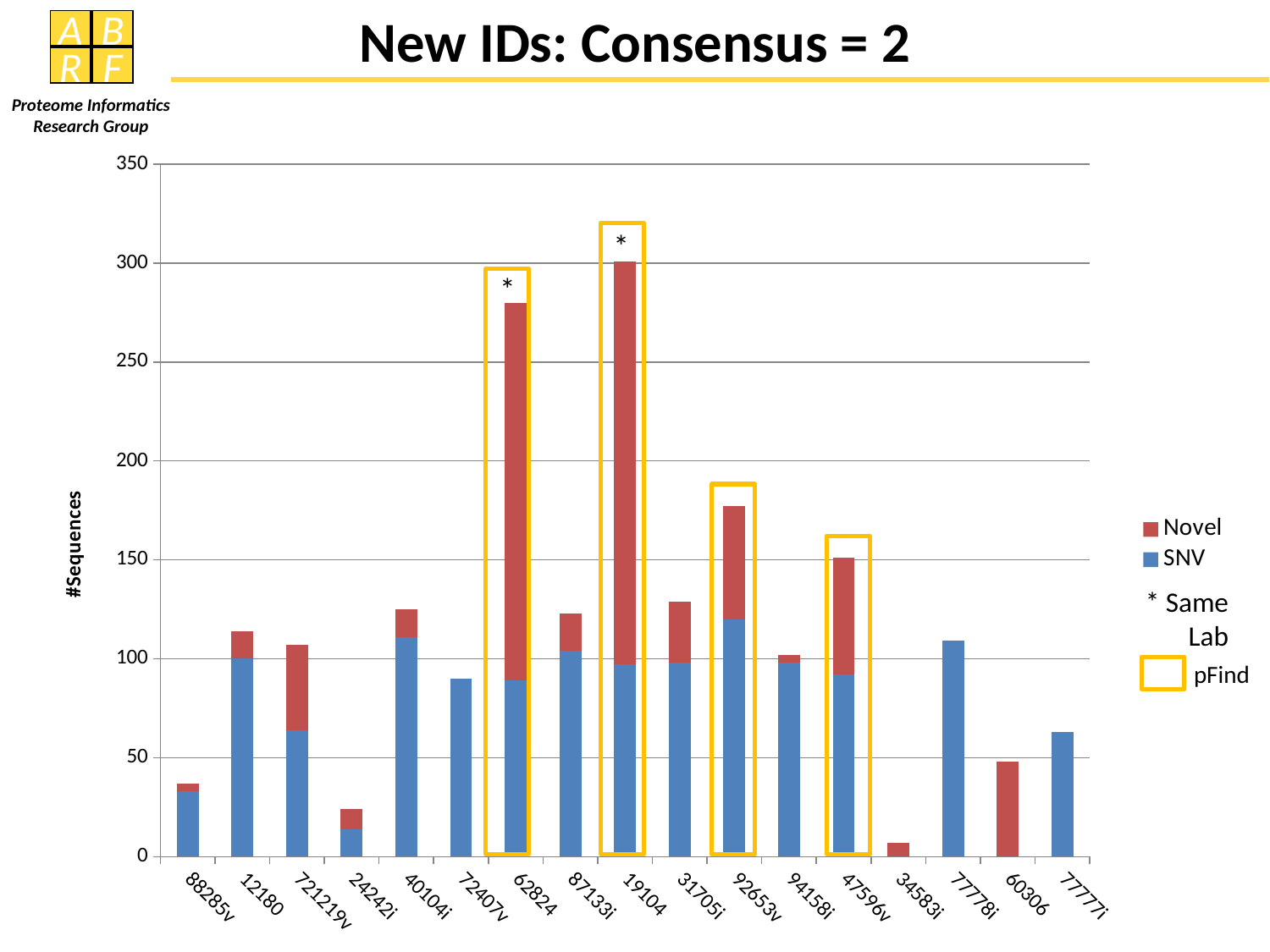
What is the label on the y axis of the chart? #Sequences Which category has the tallest stacked bar? 19104 What kind of chart is shown on the slide? stacked bar chart Which category has the shortest stacked bar? 34583i How many categories are shown along the x axis of the chart? 17 Which has the taller stacked bar, 92653v or 47596v? 92653v Is the total value for 62824 greater or less than 250? greater How many series does the chart legend list? 2 What is the title of the slide's chart? New IDs: Consensus = 2 Is the value for 72407v greater or less than 100? less Is the total value for 88285v greater or less than 50? less